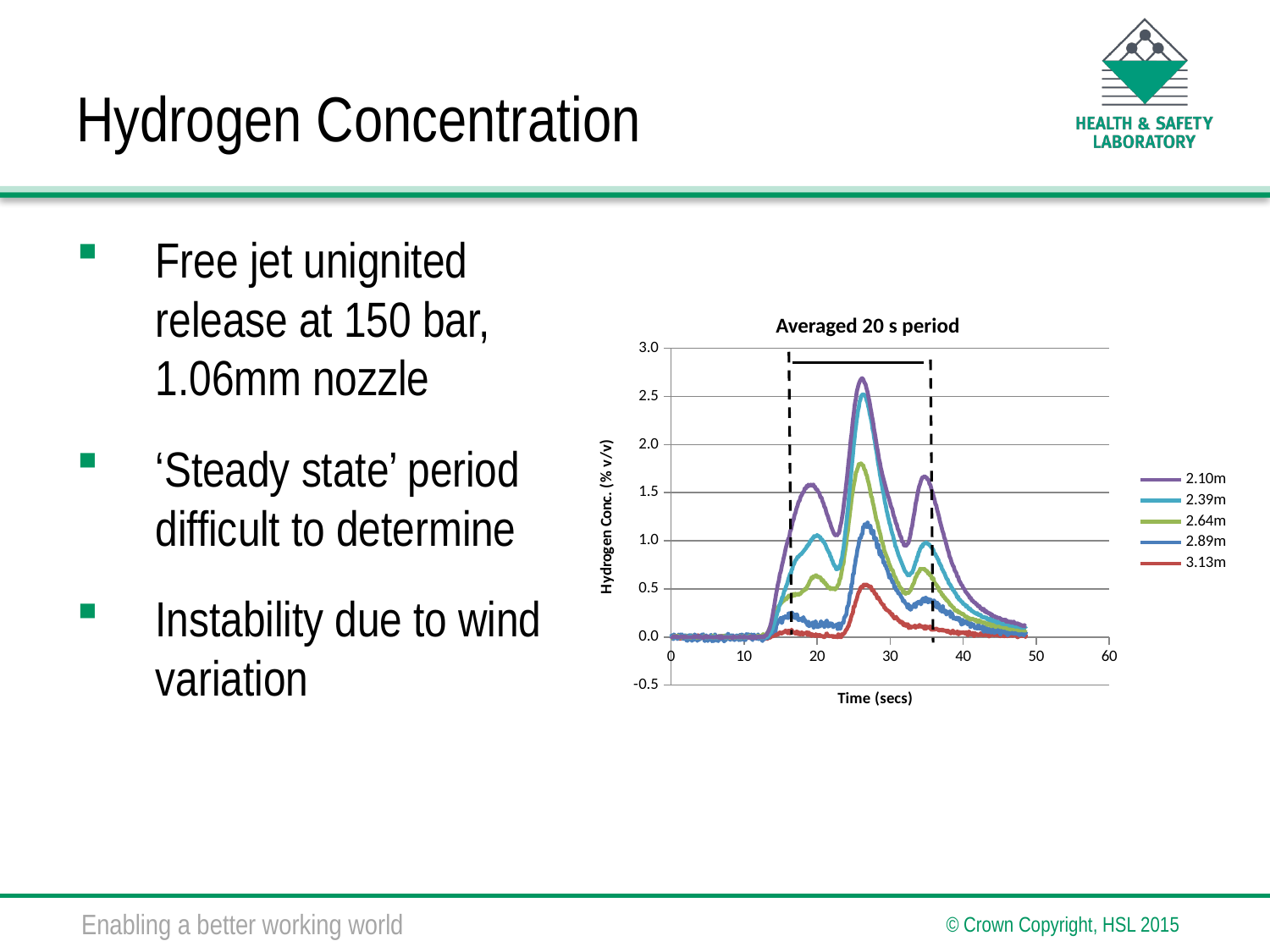
Which series has a higher peak, 2.89m or 3.13m? 2.89m Which series reaches the highest hydrogen concentration? 2.10m Which series has a higher peak, 2.39m or 2.64m? 2.39m How many series does the legend list? 5 What kind of chart is shown on the slide? line chart What is the label of the y axis? Hydrogen Conc. (% v/v) Is the peak value for the 2.10m series greater or less than 2.5? greater Is the peak value for the 2.64m series greater or less than 1.5? greater What is the title of the chart? Averaged 20 s period Is the peak value for the 3.13m series greater or less than 1.0? less Which series has the lowest peak hydrogen concentration? 3.13m